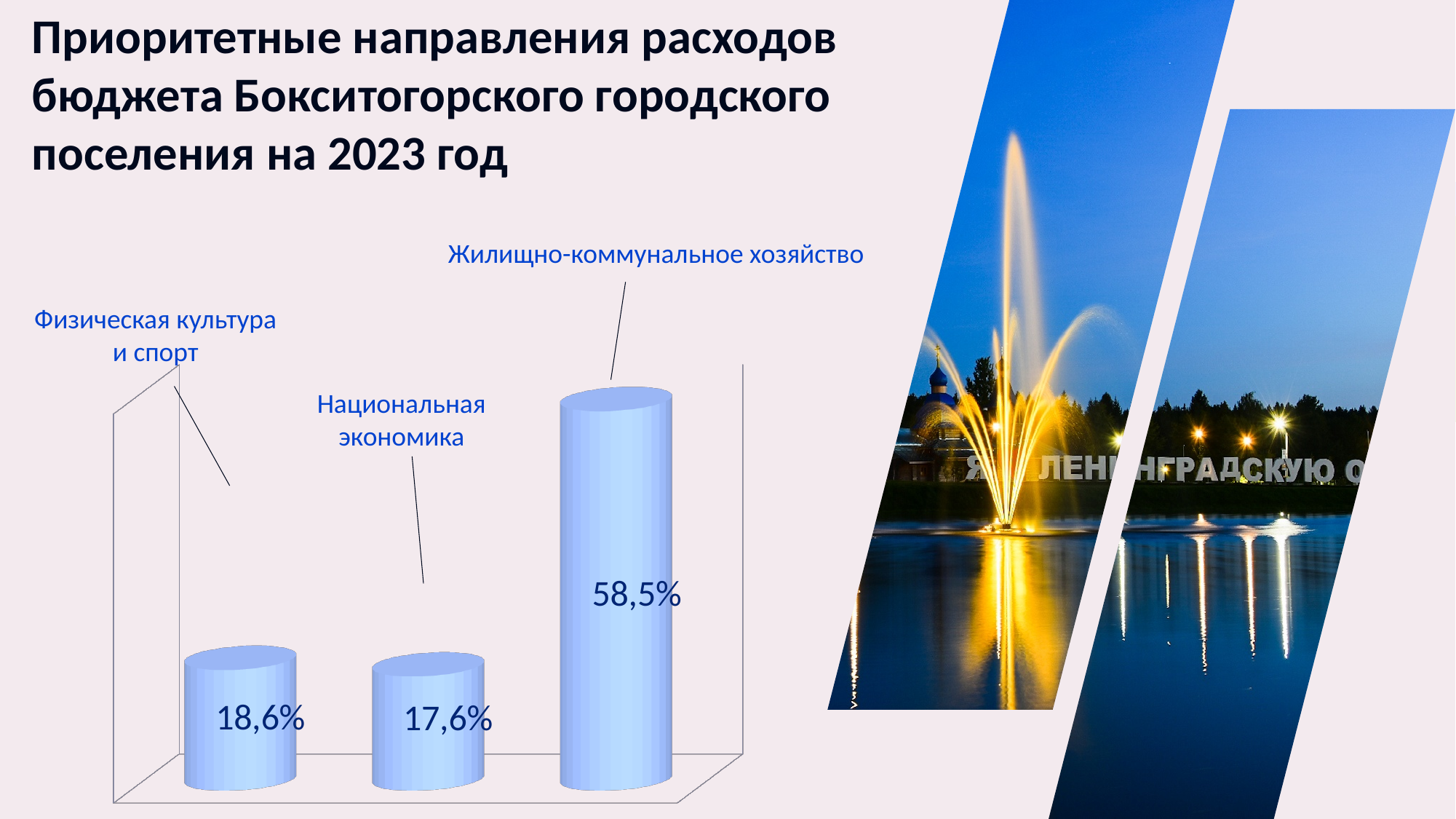
What kind of chart is shown on the slide? Bar chart What is the difference between the values for Жилищно-коммунальное хозяйство and Физическая культура и спорт? 39,9% What is the value for Жилищно-коммунальное хозяйство? 58,5% What year does the slide title say the budget expenditure priorities are for? 2023 Which category has the highest value? Жилищно-коммунальное хозяйство Which is larger, the value for Физическая культура и спорт or the value for Национальная экономика? Физическая культура и спорт What is the value for Физическая культура и спорт? 18,6% Which category has the lowest value? Национальная экономика What is the difference between the values for Жилищно-коммунальное хозяйство and Национальная экономика? 40,9% What is the difference between the values for Физическая культура и спорт and Национальная экономика? 1,0% How many categories are shown in the chart? 3 What is the value for Национальная экономика? 17,6%